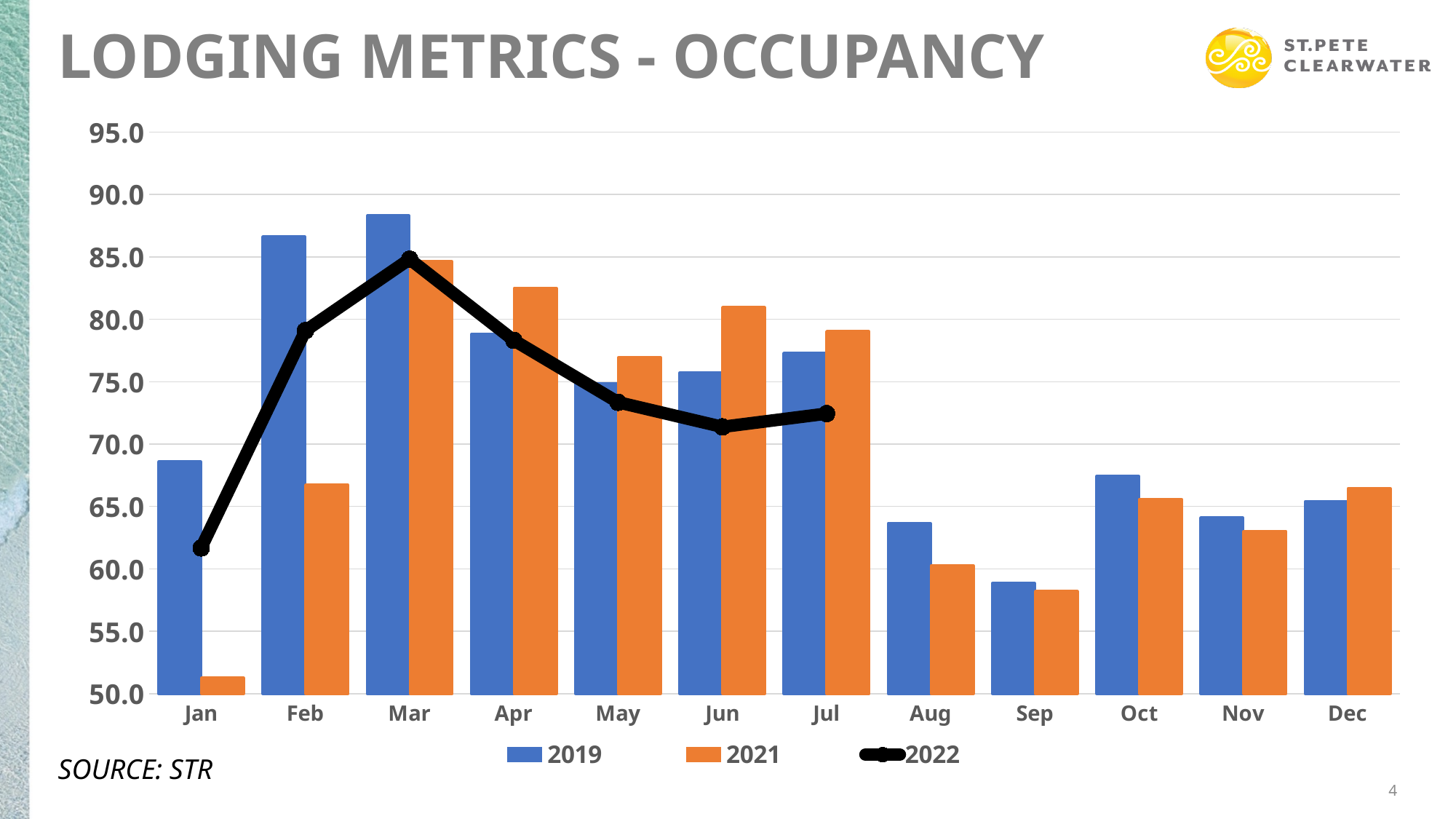
What kind of chart is shown on the slide? A combined bar and line chart Is the 2019 value for Mar greater or less than 85.0? greater In Jan, which is larger: the 2019 value or the 2021 value? 2019 How many series does the legend list? 3 In which month is the 2019 occupancy highest? Mar In which month is the 2019 occupancy lowest? Sep Does the 2022 line rise or fall from Mar to Jun? fall In Jun, which is larger: the 2019 value or the 2021 value? 2021 How many months are shown on the x axis? 12 In which month does the 2022 line reach its highest point? Mar Is the 2021 value for Jan greater or less than 55.0? less In which month is the 2021 occupancy lowest? Jan